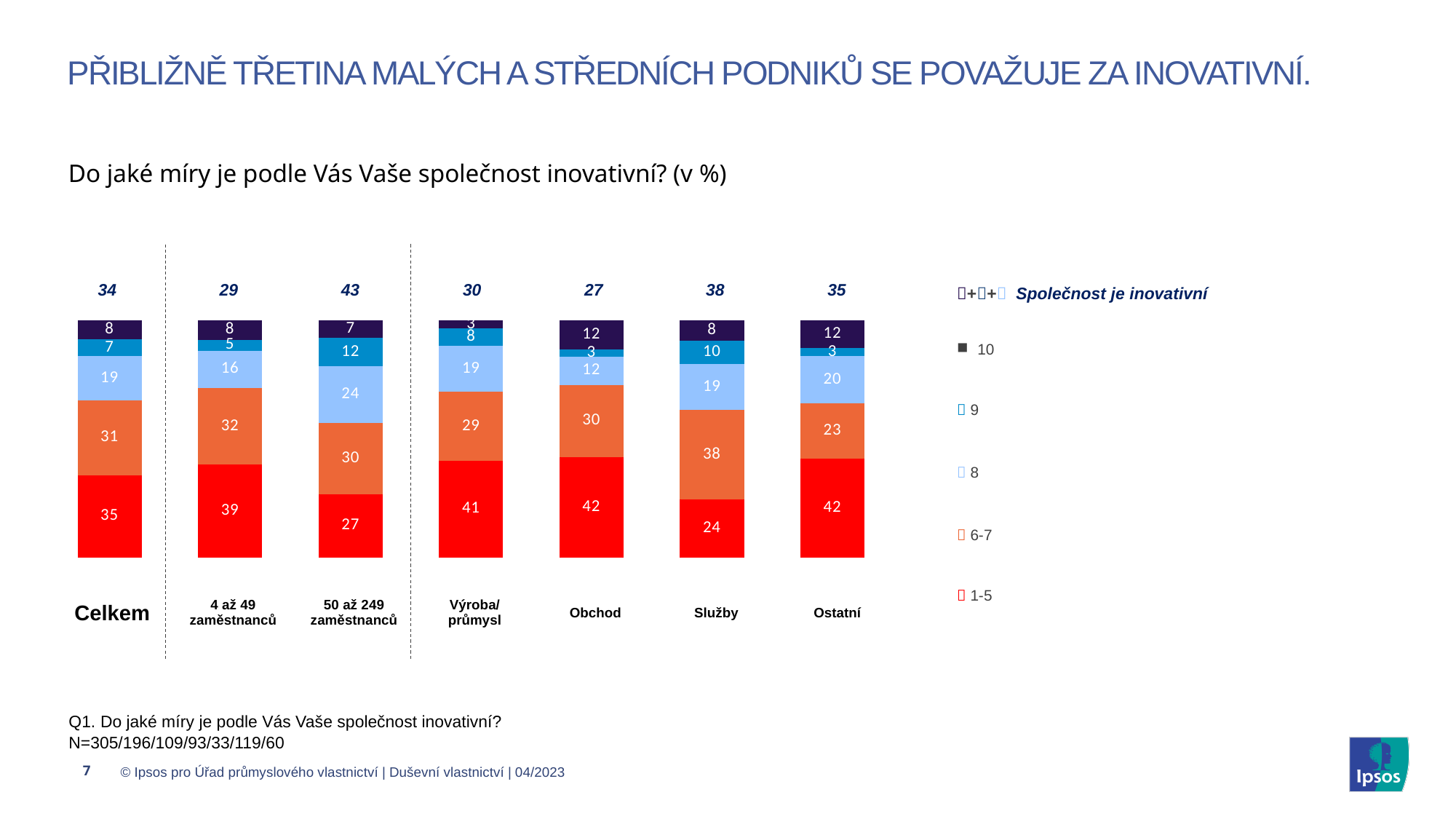
How many categories (bars) are shown in the chart? 7 Which is larger: the '10' segment for Obchod or the '10' segment for Výroba/průmysl? Obchod Which category has the lowest 'Společnost je inovativní' value shown above the bars? Obchod What is the 'Společnost je inovativní' total shown above the bar for 50 až 249 zaměstnanců? 43 What is the value of the '6-7' segment for Služby? 38 How many series does the legend list for the stacked bars (excluding the combined 'Společnost je inovativní' label)? 5 What is the value of the '1-5' segment for Celkem? 35 What is the value of the '9' segment for Ostatní? 3 What is the difference between the '1-5' values for 4 až 49 zaměstnanců and 50 až 249 zaměstnanců? 12 What is the value of the '8' segment for 50 až 249 zaměstnanců? 24 Which category has the highest 'Společnost je inovativní' value shown above the bars? 50 až 249 zaměstnanců What kind of chart is shown on the slide? stacked bar chart